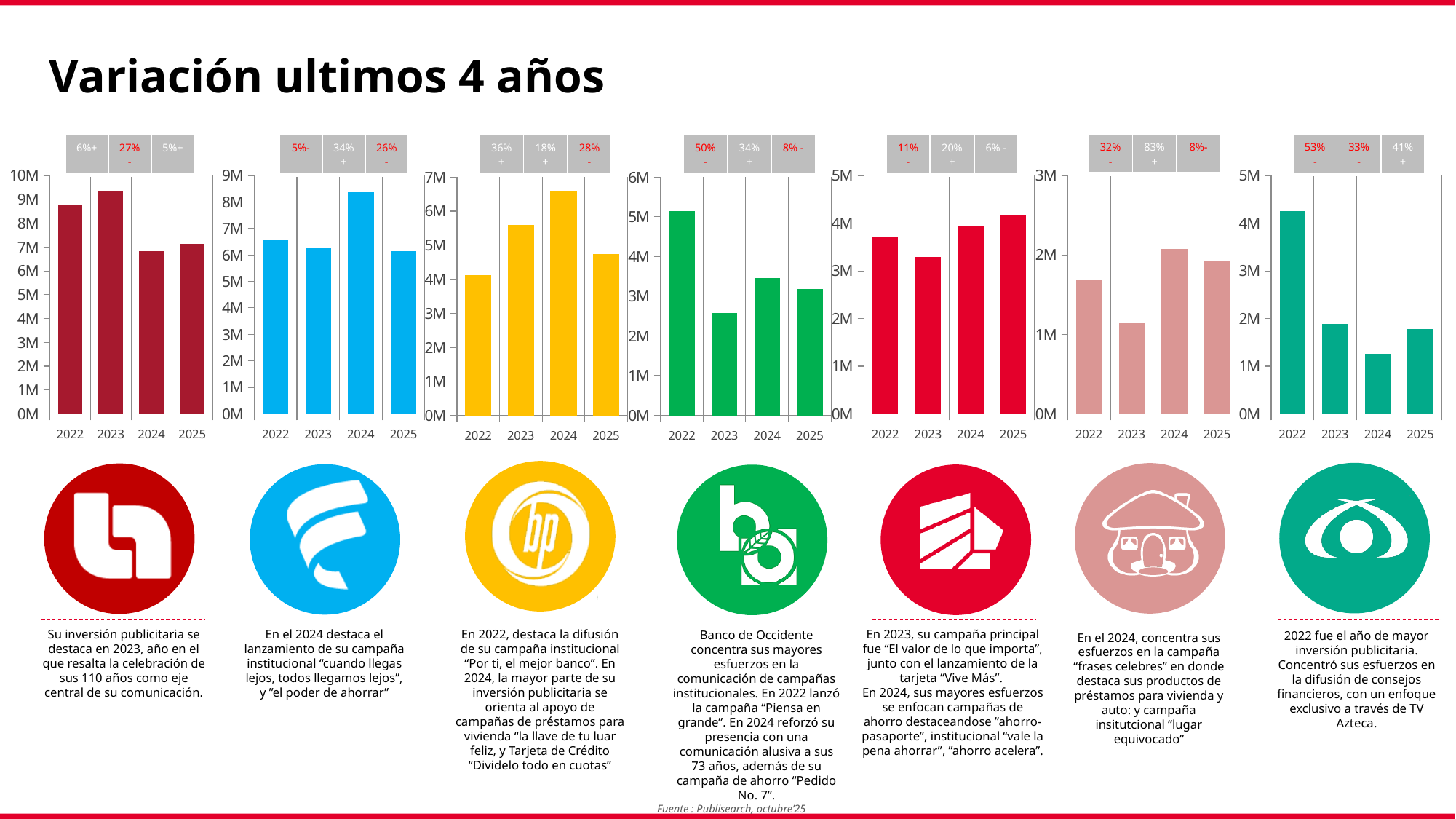
In the fourth chart from the left (green bars), which is larger, the value for 2022 or the value for 2024? 2022 In the first chart from the left (dark red bars), which year has the highest value? 2023 What kind of chart is the first chart from the left (dark red bars)? bar chart In the third chart from the left (yellow bars), which year has the lowest value? 2022 In the fourth chart from the left (green bars), is the value for 2023 greater or less than 3M? less In the second chart from the left (blue bars), which year has the highest value? 2024 In the sixth chart from the left (pink bars), which year has the highest value? 2024 In the first chart from the left (dark red bars), is the value for 2022 greater or less than 8M? greater In the third chart from the left (yellow bars), is the value for 2024 greater or less than 6M? greater In the fifth chart from the left (red bars), which year has the lowest value? 2023 How many years are shown on the x axis of the seventh chart from the left (teal bars)? 4